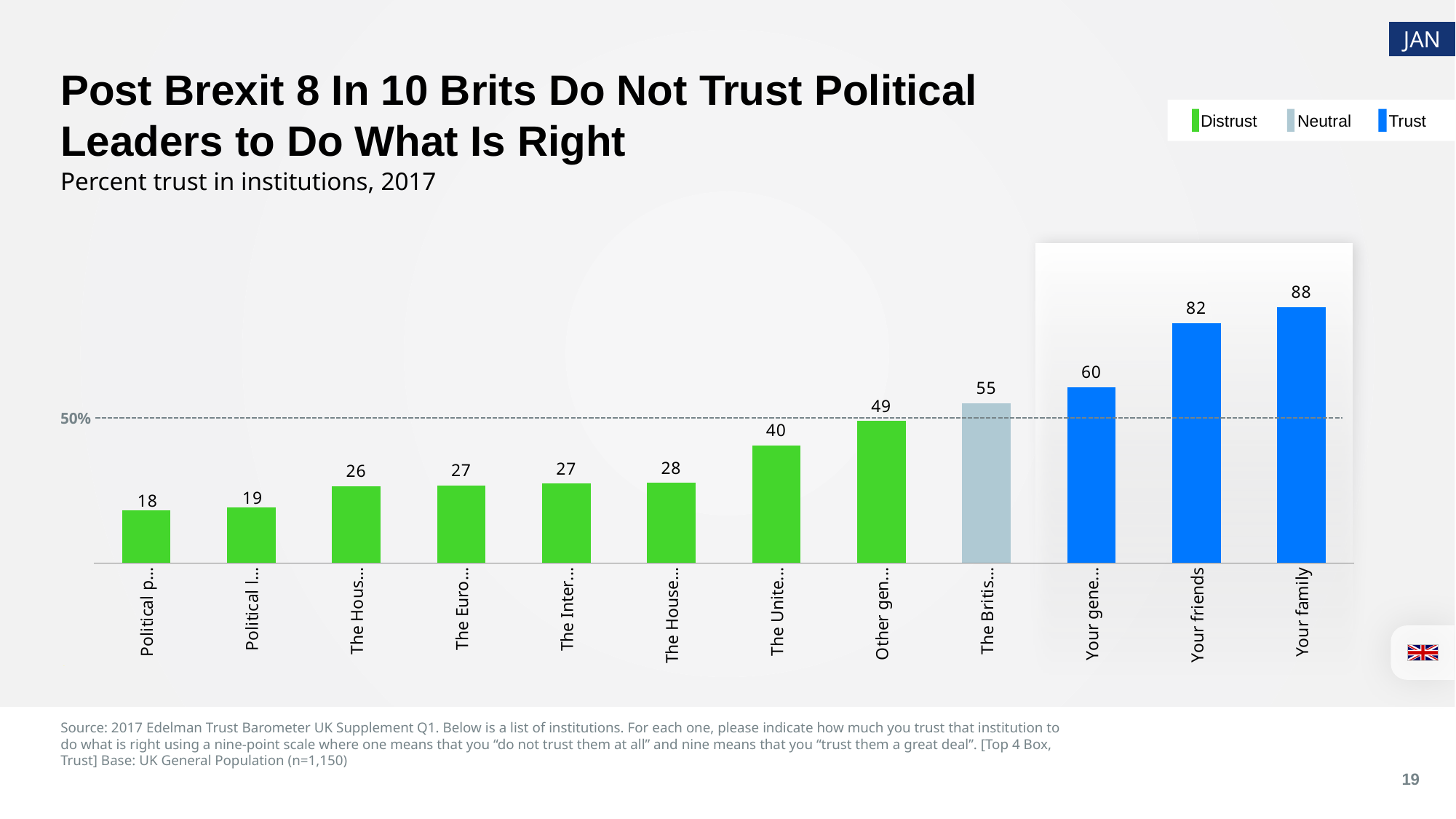
Is the value for Your friends greater or less than 50%? greater What colour does the legend use for Trust? blue Do the values rise or fall from left to right along the x axis? rise What is the value for Your family? 88 What is the lowest value shown on the chart? 18 Which is larger, the value for Your friends or the value for Your family? Your family Which category has the highest value? Your family How many entries does the legend list? 3 What kind of chart is shown on the slide? bar chart How many bars are shown on the chart? 12 What is the difference between the values for Your family and Your friends? 6 What is the value for Your friends? 82